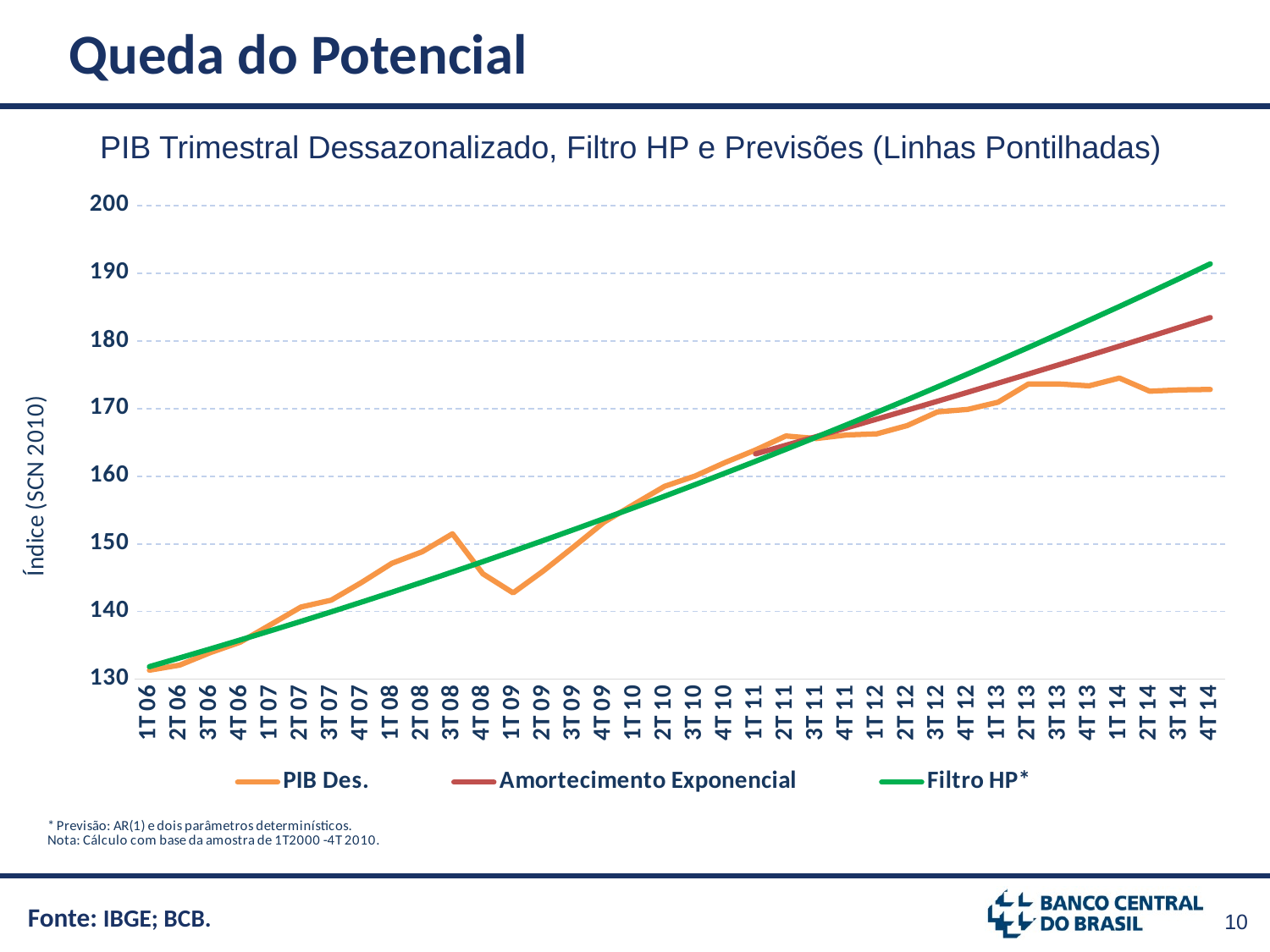
What is the label of the y axis? Índice (SCN 2010) How many quarters are plotted along the x axis? 36 Which series reaches the highest value at 4T 14? Filtro HP* Is the value of PIB Des. at 4T 14 greater or less than 180? less At 4T 14, which is higher: Amortecimento Exponencial or PIB Des.? Amortecimento Exponencial What kind of chart is shown on the slide? line chart How many series does the legend list? 3 Which series is plotted in green? Filtro HP* At 4T 14, which is higher: Filtro HP* or PIB Des.? Filtro HP* Is the value of Filtro HP* at 4T 14 greater or less than 180? greater Is the value of PIB Des. at 1T 09 greater or less than 150? less